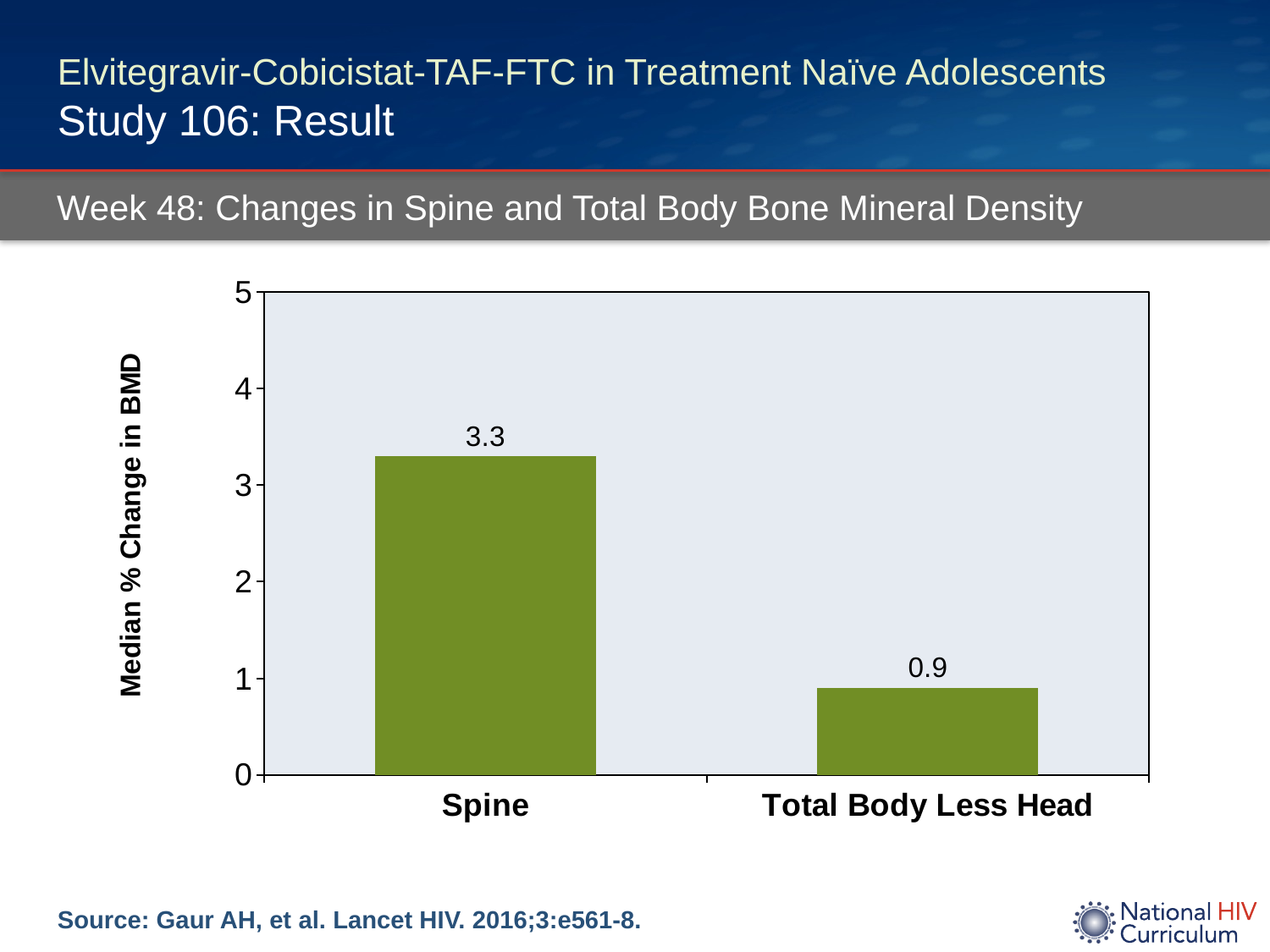
What is the label of the y axis of the chart? Median % Change in BMD What is the maximum value shown on the y axis of the chart? 5 Which category has the highest median % change in BMD? Spine What kind of chart is shown on the slide? Bar chart Which category has the lowest median % change in BMD? Total Body Less Head What is the median % change in BMD for Total Body Less Head? 0.9 What is the difference in median % change in BMD between Spine and Total Body Less Head? 2.4 How many categories are shown on the x axis of the chart? 2 Is the value for Total Body Less Head greater or less than 1? less Is the value for Spine greater or less than 3? greater Which is larger, the median % change in BMD for Spine or for Total Body Less Head? Spine What is the median % change in BMD for Spine? 3.3